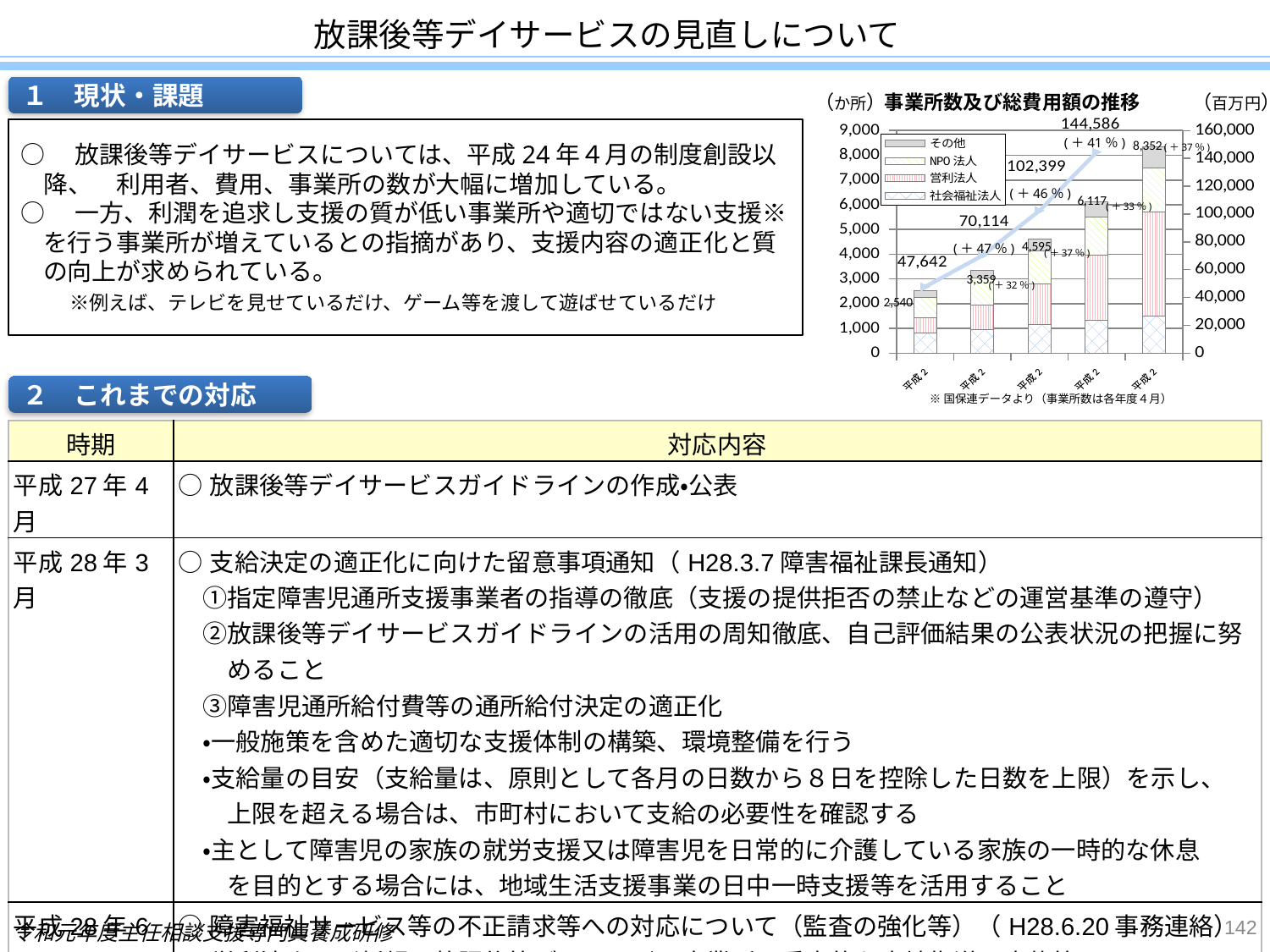
What is the total labeled on the shortest stacked bar in the chart? 2,540 What is the highest value labeled on the line in the chart? 144,586 How many stacked bars are plotted in the chart? 5 How many entries does the chart's legend list? 4 What is the difference between the tallest bar total (8,352) and the shortest bar total (2,540)? 5,812 What is the total labeled on the tallest stacked bar in the chart? 8,352 Do the stacked bar totals rise or fall from left to right along the x axis? Rise What kind of chart is shown on the slide? A combination of a stacked bar chart and a line chart What is the lowest value labeled on the line in the chart? 47,642 What is the difference between the line values 102,399 and 70,114? 32,285 What unit is shown for the right-hand axis of the chart? 百万円 What is the title of the chart on the slide? 事業所数及び総費用額の推移